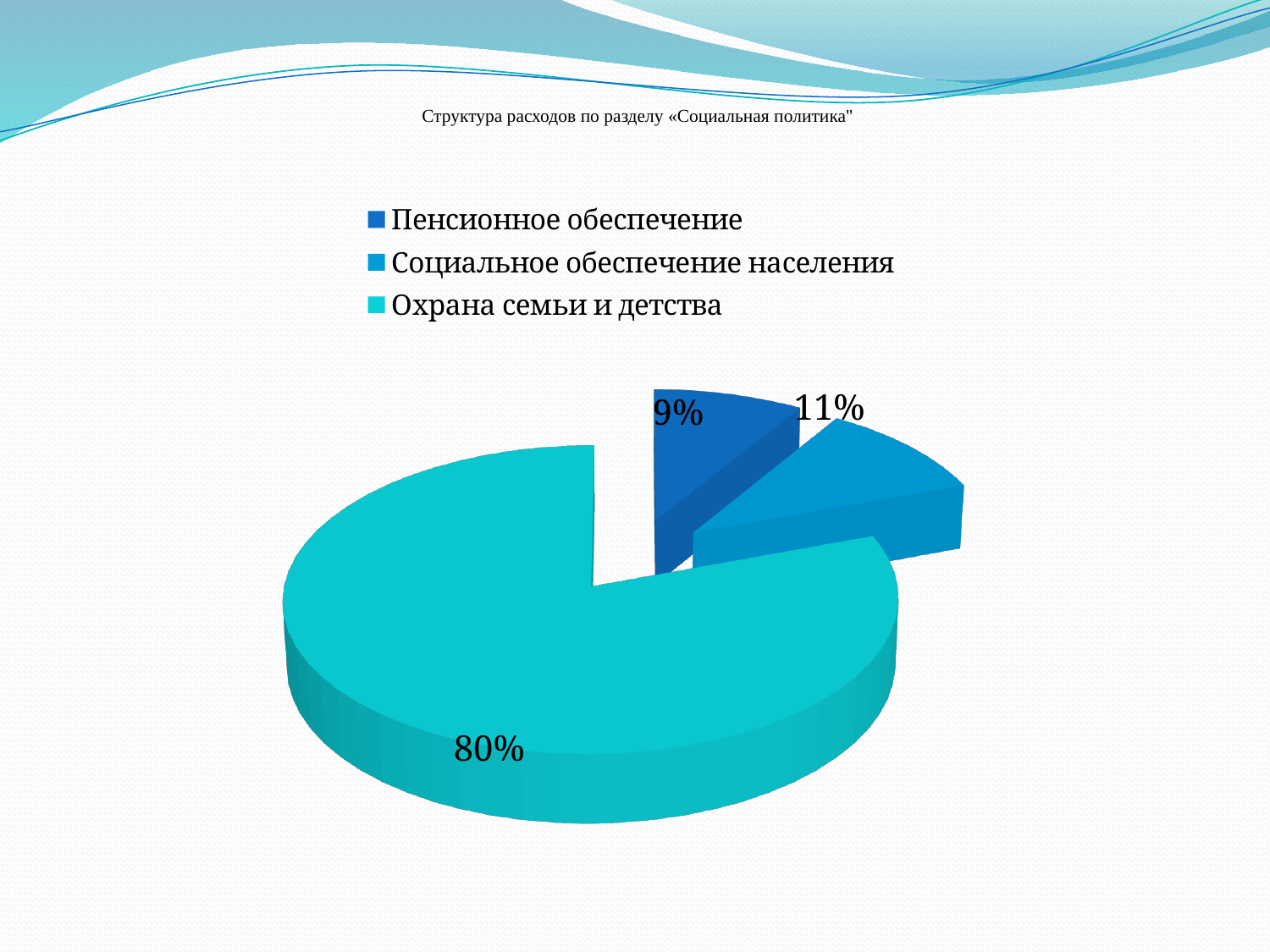
Which is larger: Социальное обеспечение населения or Пенсионное обеспечение? Социальное обеспечение населения What share of the pie does Социальное обеспечение населения have? 11% What share of the pie does Охрана семьи и детства have? 80% What kind of chart is shown on the slide? Pie chart Which category has the largest slice of the pie? Охрана семьи и детства What is the difference in percentage points between Социальное обеспечение населения and Пенсионное обеспечение? 2 What is the title of the chart? Структура расходов по разделу «Социальная политика" What share of the pie does Пенсионное обеспечение have? 9% Which category has the smallest slice of the pie? Пенсионное обеспечение How many categories does the pie chart have? 3 What is the difference in percentage points between Охрана семьи и детства and Социальное обеспечение населения? 69 Which legend entry is listed first? Пенсионное обеспечение